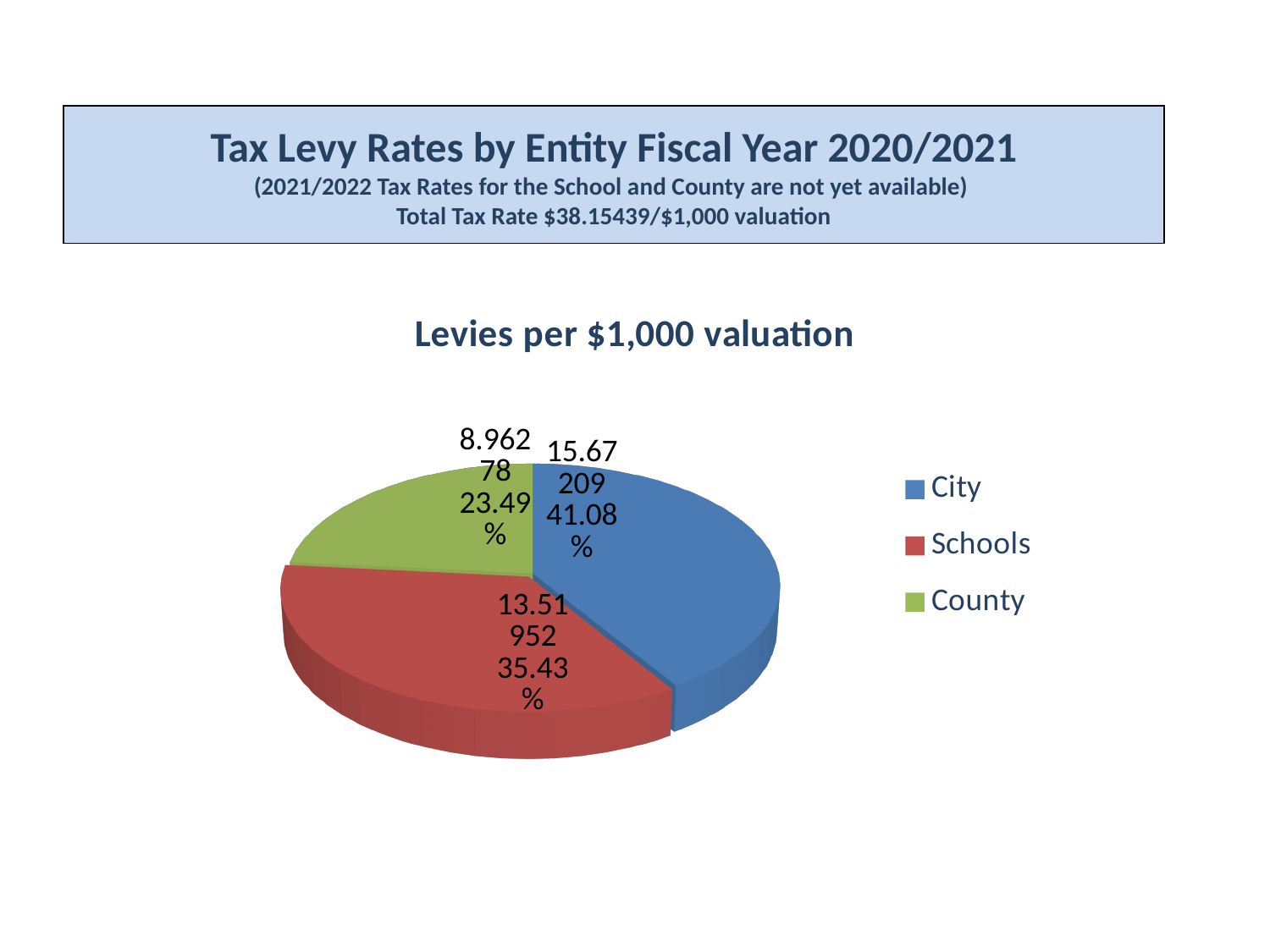
Which is larger, the levy for Schools or the levy for County? Schools Which entity has the largest levy? City What kind of chart is shown on the slide? Pie chart What share of the pie does County represent? 23.49% What is the levy value for Schools? 13.51952 Which entity has the smallest levy? County What share of the pie does Schools represent? 35.43% What is the levy value for City? 15.67209 What is the title of the chart? Levies per $1,000 valuation What is the levy value for County? 8.96278 What share of the pie does City represent? 41.08% How many entities does the legend list? 3